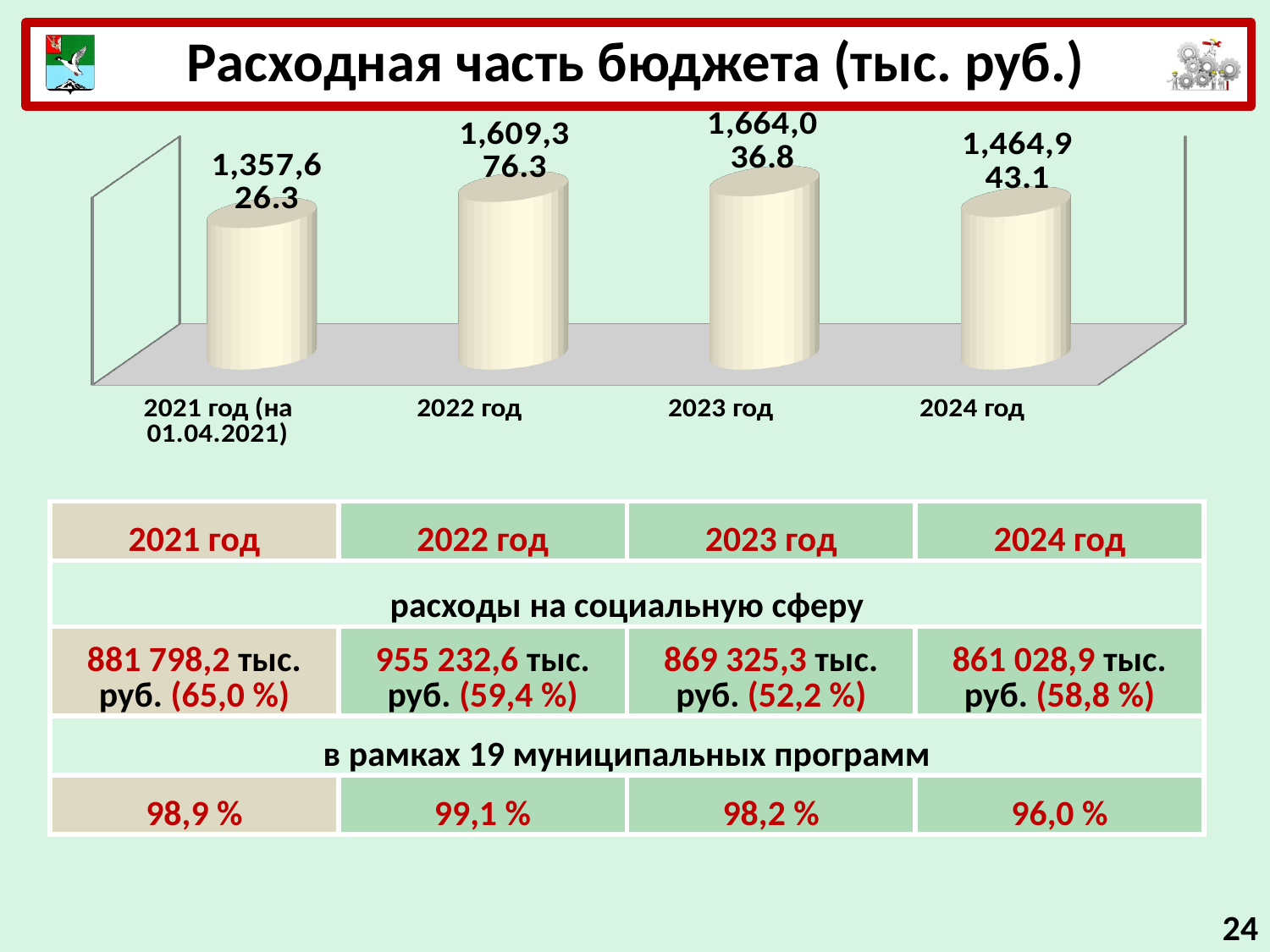
What is the value shown for 2021 год (на 01.04.2021) on the chart? 1,357,626.3 What is the value shown for 2023 год on the chart? 1,664,036.8 Which is larger on the chart, the value for 2022 год or the value for 2024 год? 2022 год Which year has the lowest value on the chart? 2021 год (на 01.04.2021) What is the title of the chart on the slide? Расходная часть бюджета (тыс. руб.) Which year has the highest value on the chart? 2023 год What is the value shown for 2022 год on the chart? 1,609,376.3 What is the value shown for 2024 год on the chart? 1,464,943.1 What is the difference between the values for 2023 год and 2022 год on the chart? 54,660.5 Do the values on the chart rise or fall from 2023 год to 2024 год? Fall What kind of chart is shown on the slide? Bar chart How many years (categories) are plotted on the chart? 4